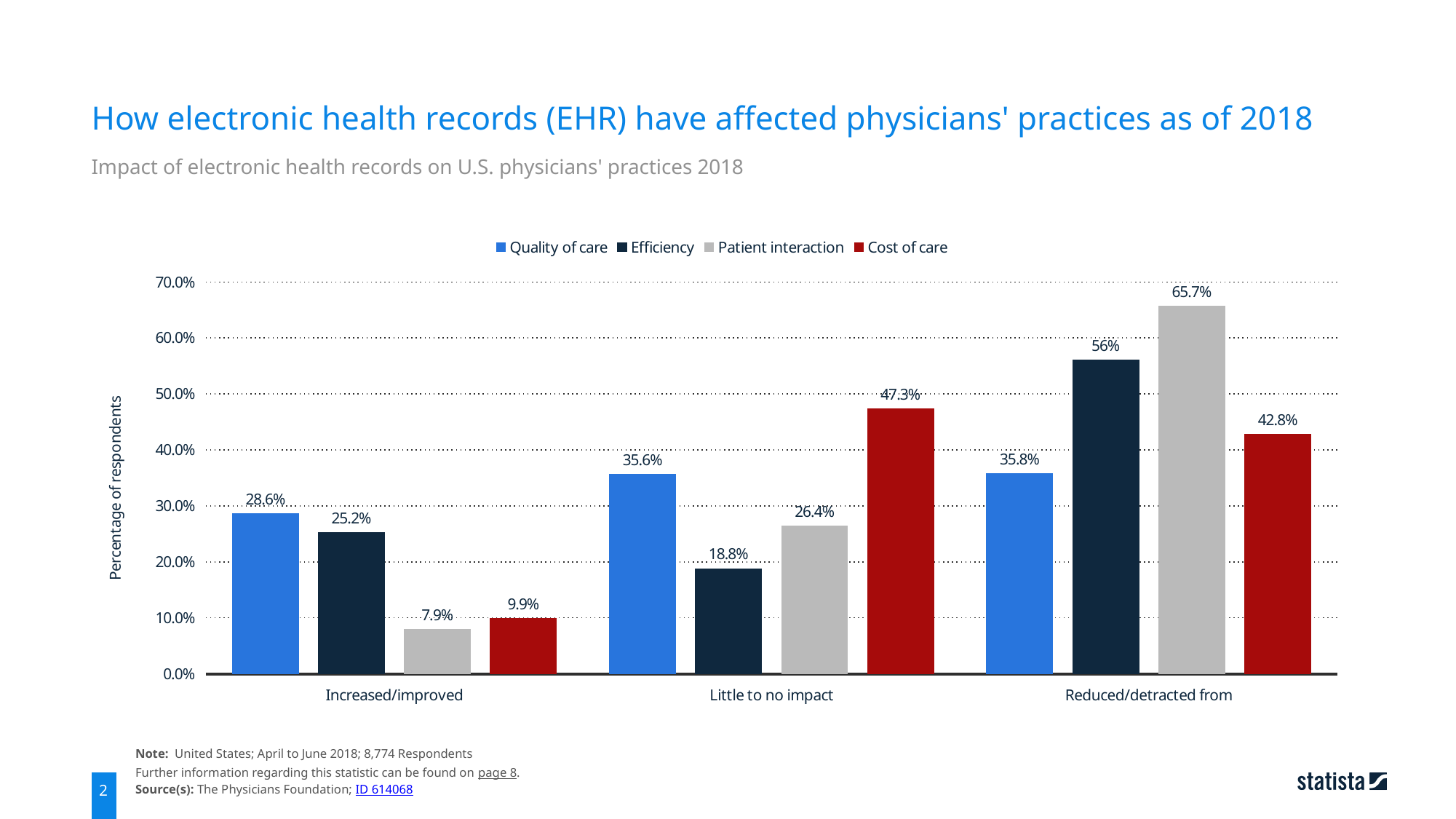
What is the label of the y axis? Percentage of respondents What is the value for Efficiency in the Little to no impact category? 18.8% How many series does the legend list? 4 Which is larger: Quality of care in Little to no impact or Quality of care in Reduced/detracted from? Reduced/detracted from Which series has the lowest value in the Increased/improved category? Patient interaction What is the difference between the Cost of care values for Little to no impact and Increased/improved? 37.4% Is the value for Efficiency in the Reduced/detracted from category greater or less than 50%? greater What is the value for Patient interaction in the Reduced/detracted from category? 65.7% What percentage of respondents said EHR increased/improved quality of care? 28.6% What kind of chart is shown on the slide? Bar chart Which series has the highest value in the Reduced/detracted from category? Patient interaction How many categories are shown on the x axis? 3